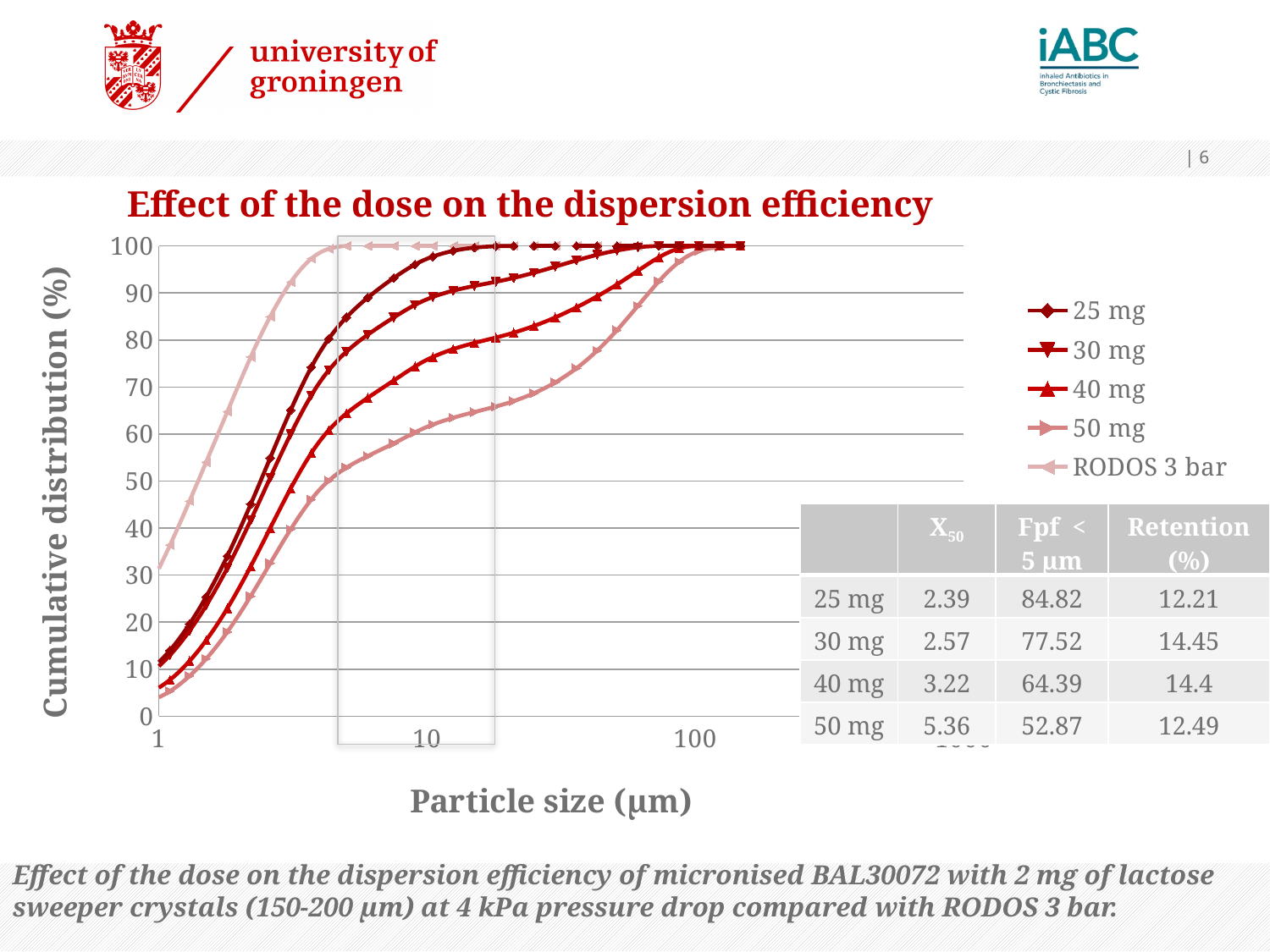
What is the title of the chart? Effect of the dose on the dispersion efficiency Which series has the lowest cumulative distribution at a particle size of 10 µm? 50 mg How many series does the chart legend list? 5 At a particle size of 10 µm, is the cumulative distribution for 40 mg greater or less than 80? less At a particle size of 10 µm, which series has the larger cumulative distribution, 25 mg or 40 mg? 25 mg Which series reaches 100% cumulative distribution at the smallest particle size? RODOS 3 bar What kind of chart is shown on the slide? line chart Do the cumulative distribution values rise or fall as particle size increases along the x axis? rise At a particle size of 1 µm, is the cumulative distribution for RODOS 3 bar greater or less than 20? greater At a particle size of 10 µm, is the cumulative distribution for 25 mg greater or less than 90? greater What is the label of the x axis of the chart? Particle size (µm)